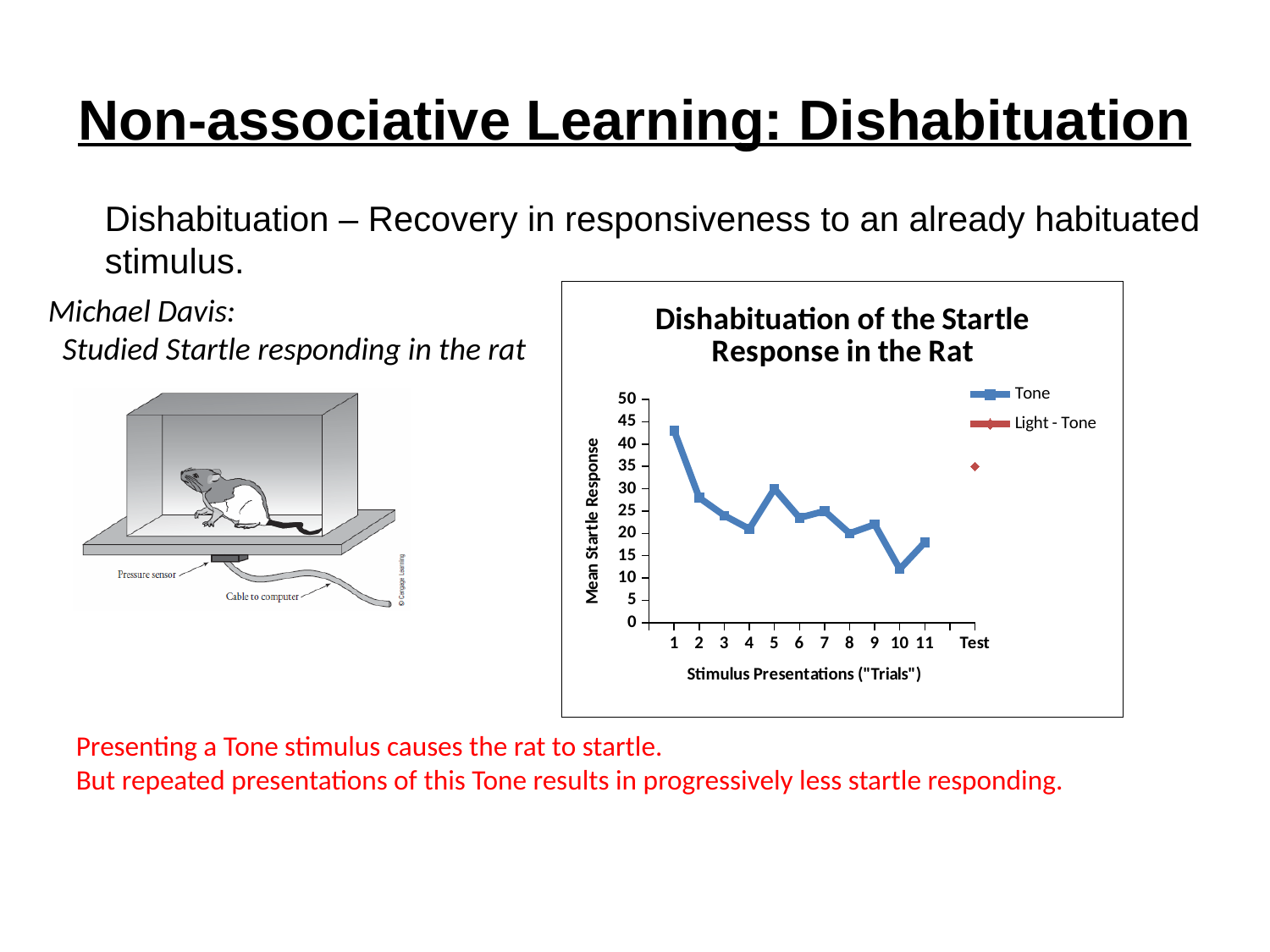
Is the Light - Tone value at Test greater or less than 30? greater Overall, does the Tone series rise or fall from trial 1 to trial 11? fall How many numbered trials are shown on the x axis for the Tone series? 11 At which trial is the Tone series lowest? 10 What kind of chart is shown on the slide? line chart At which trial is the Tone series highest? 1 How many series does the legend list? 2 Is the Tone value at trial 1 greater or less than 40? greater What are the two series named in the legend? Tone and Light - Tone Is the Tone value at trial 10 greater or less than 15? less Which is larger: the Tone value at trial 5 or the Tone value at trial 4? trial 5 What is the title of the chart? Dishabituation of the Startle Response in the Rat